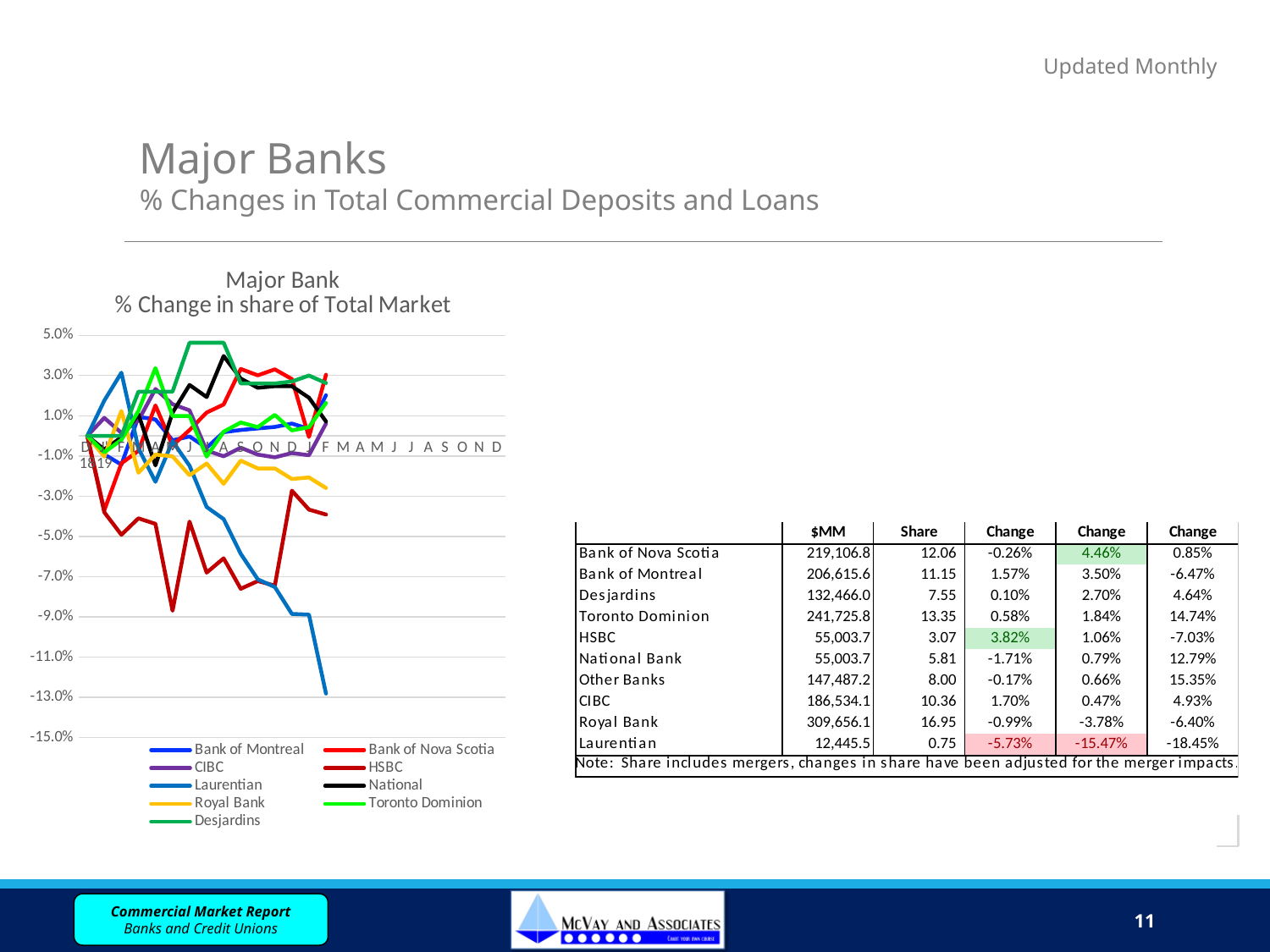
Is the peak value for Toronto Dominion greater or less than 3.0%? greater What is the lowest value shown on the vertical axis of the chart? -15.0% Is the final plotted value for Laurentian greater or less than -11.0%? less Is the lowest value for HSBC greater or less than -7.0%? less Does the Laurentian line generally rise or fall over the plotted period? Fall Which series ends at the lowest value on the right-hand end of the plotted lines? Laurentian What kind of chart is shown on the slide? Line chart What is the title of the line chart? Major Bank % Change in share of Total Market Which series reaches the highest value on the chart? Desjardins How many series does the legend of the line chart list? 9 At the end of the plotted lines, which is higher: Toronto Dominion or Laurentian? Toronto Dominion